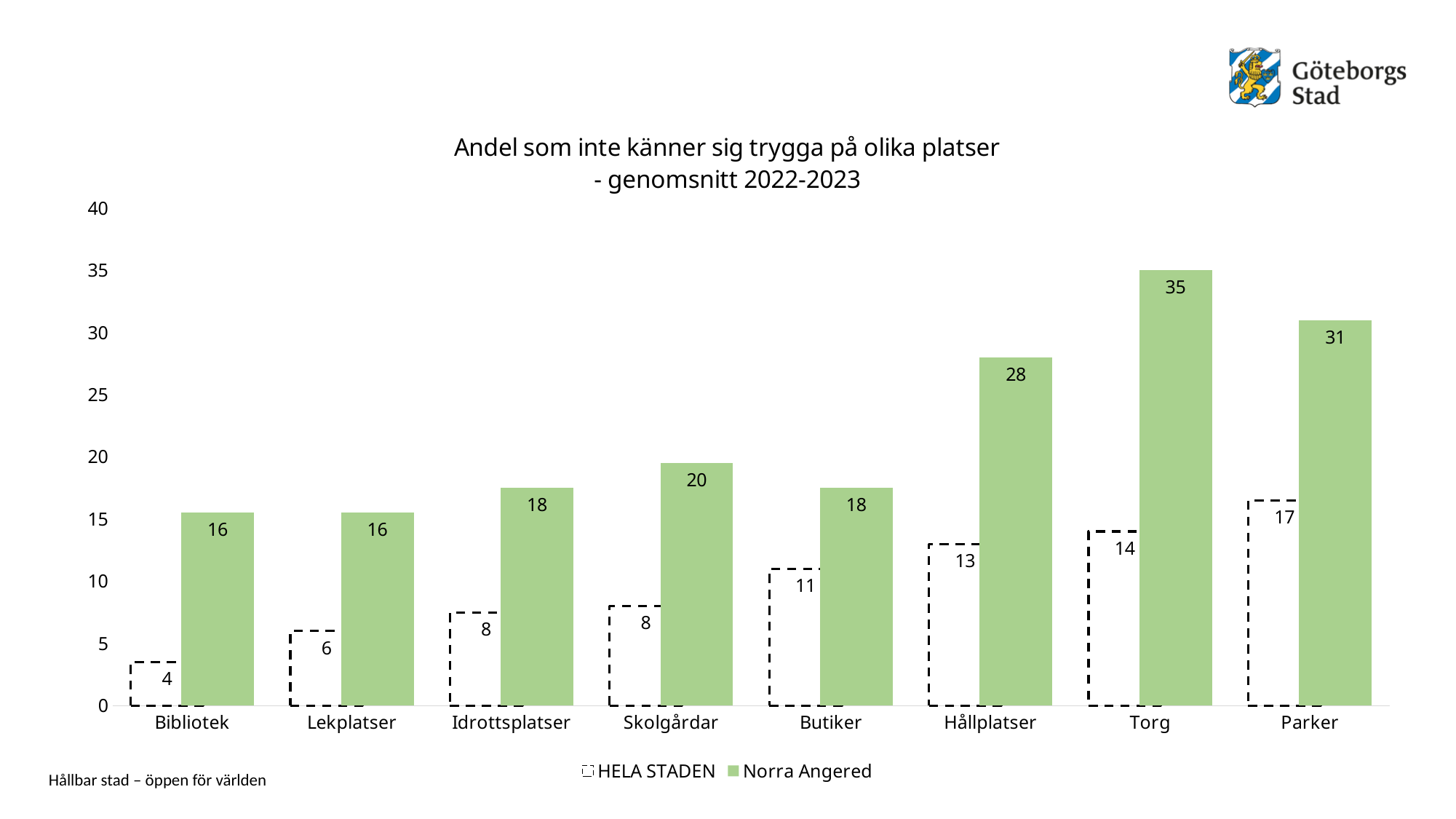
What is the difference between Norra Angered and HELA STADEN at Torg? 21 What is the value for Norra Angered at Skolgårdar? 20 What is the title of the chart? Andel som inte känner sig trygga på olika platser - genomsnitt 2022-2023 Which category has the lowest value for HELA STADEN? Bibliotek What is the value for Norra Angered at Torg? 35 How many series does the legend list? 2 What kind of chart is shown on the slide? Bar chart Is the value for Norra Angered at Parker greater or less than 30? greater What is the value for HELA STADEN at Bibliotek? 4 Which category has the highest value for Norra Angered? Torg How many categories are shown on the x axis? 8 Which is larger for Norra Angered: Hållplatser or Parker? Parker